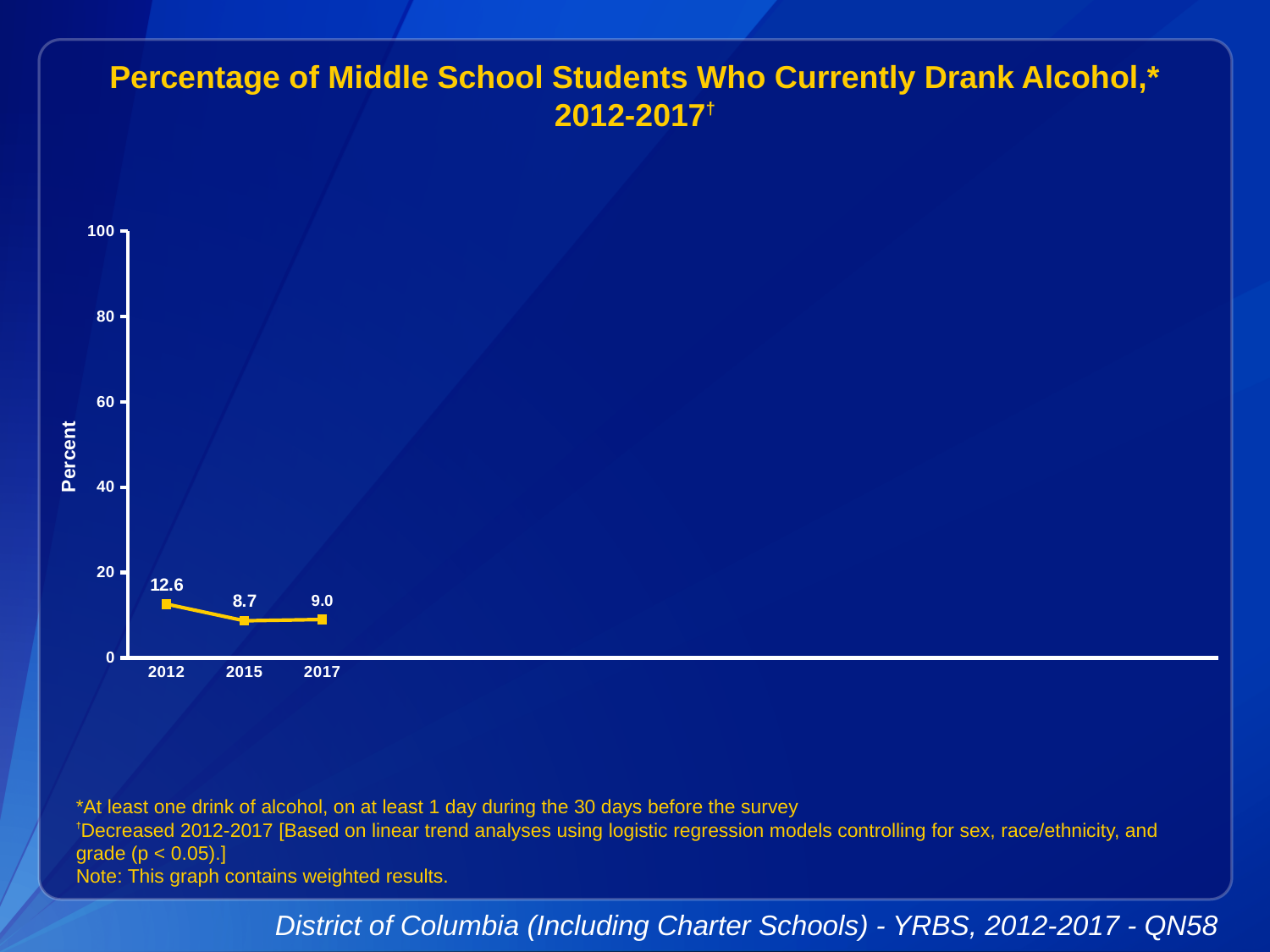
What kind of chart is shown on the slide? line chart What is the value for 2015? 8.7 How many years are plotted on the chart? 3 Which year has the highest value? 2012 What is the value for 2017? 9.0 What is the value for 2012? 12.6 What is the difference between the values for 2012 and 2015? 3.9 Is the value for 2012 greater or less than 20? less What is the difference between the values for 2012 and 2017? 3.6 What is the label of the y axis? Percent Which is larger, the value for 2015 or the value for 2017? 2017 Which year has the lowest value? 2015